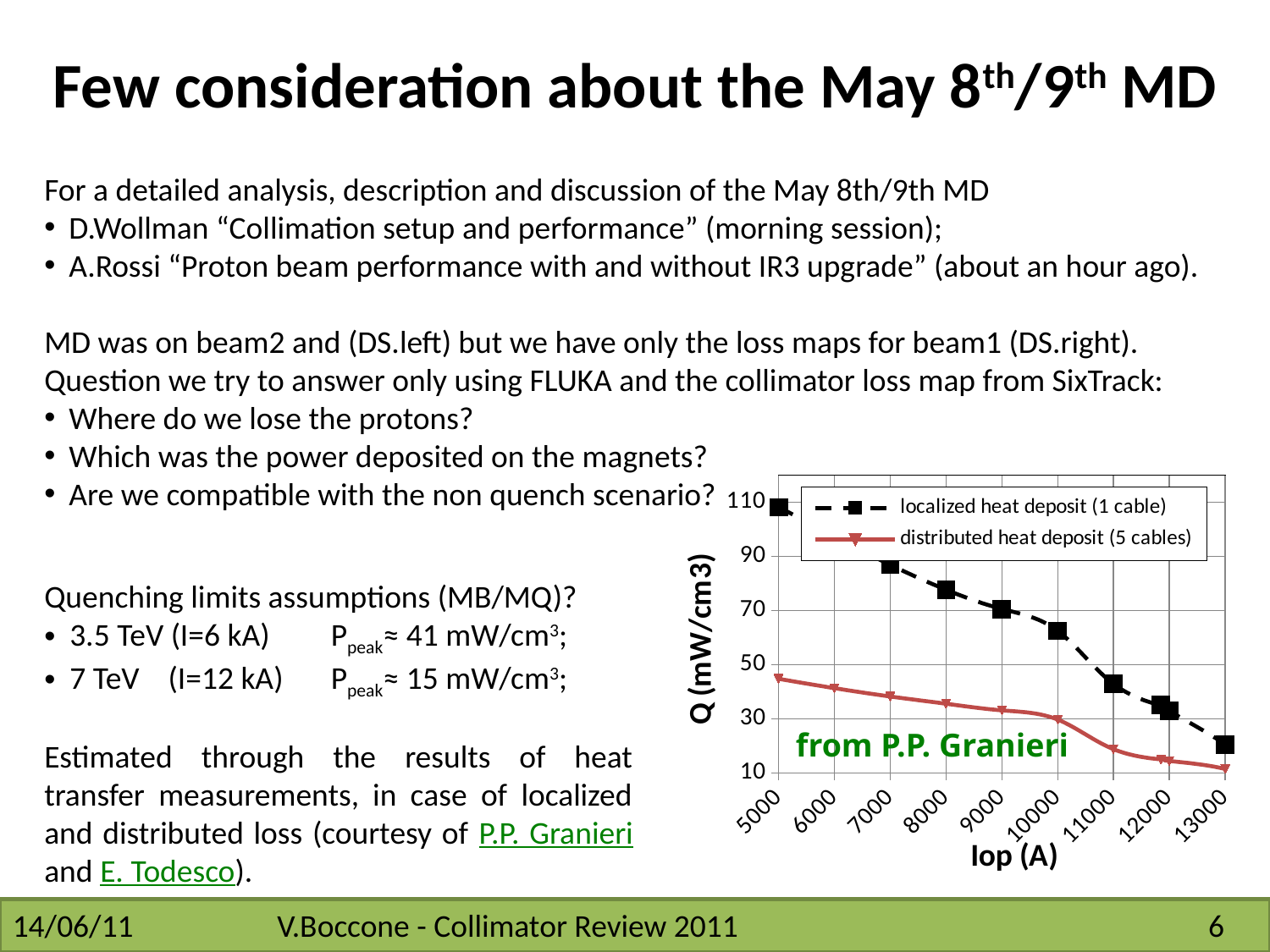
Is the value of the distributed heat deposit (5 cables) series at Iop = 10000 A greater or less than 50? less At Iop = 5000 A, which series has the higher value: localized heat deposit (1 cable) or distributed heat deposit (5 cables)? localized heat deposit (1 cable) Does the localized heat deposit (1 cable) series rise or fall as Iop increases? fall Does the distributed heat deposit (5 cables) series rise or fall as Iop increases? fall Is the value of the localized heat deposit (1 cable) series at Iop = 9000 A greater or less than 50? greater What kind of chart is shown on the slide? line chart What is the title of the x axis of the chart? Iop (A) Is the value of the localized heat deposit (1 cable) series at Iop = 13000 A greater or less than 30? less How many series does the chart legend list? 2 What is the title of the y axis of the chart? Q (mW/cm3)